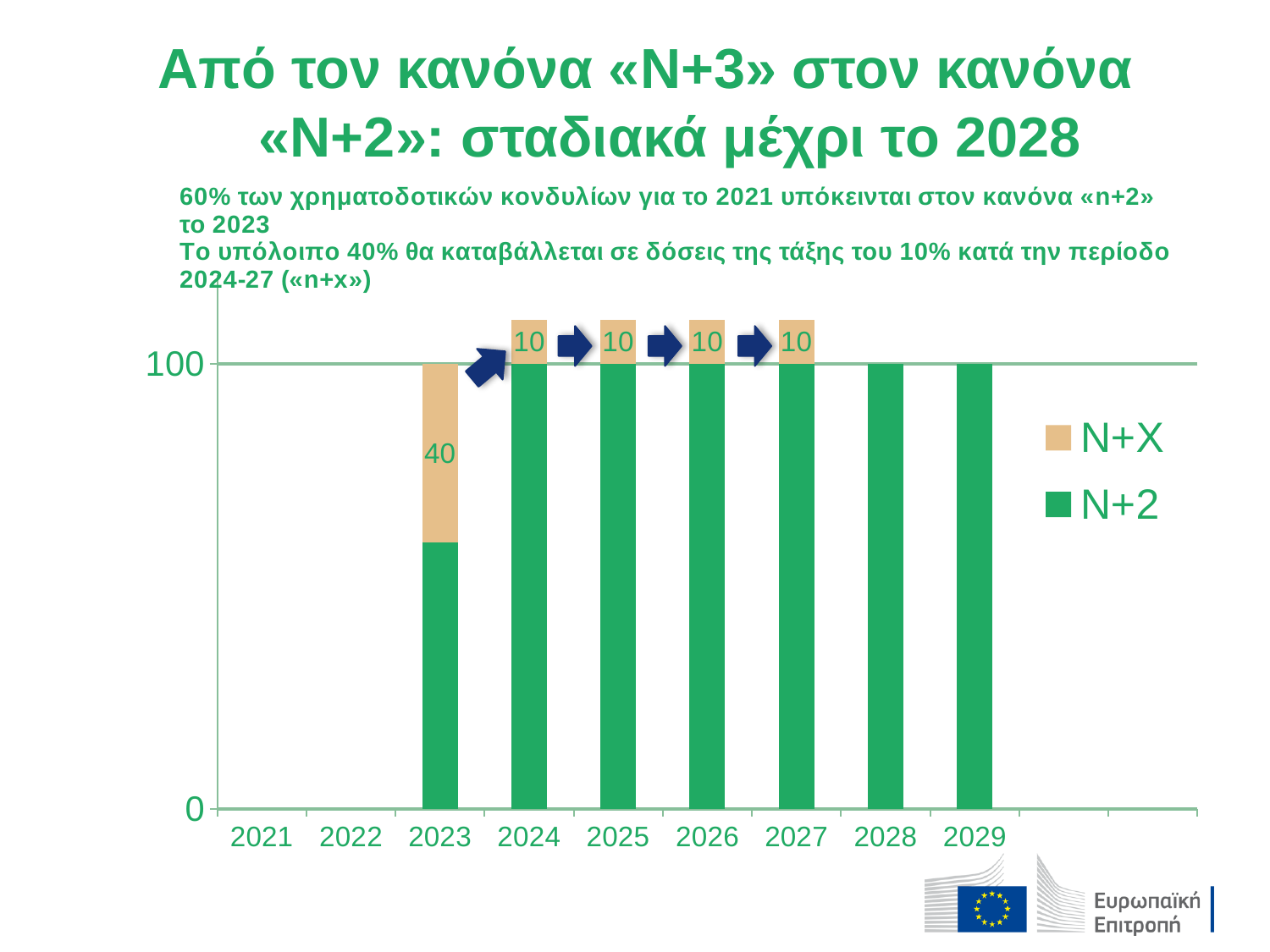
Which year has the highest N+X value? 2023 Is the N+2 value for 2023 greater or less than 100? less What is the N+X value for 2027? 10 What is the N+2 value for 2028? 100 Which is larger, the N+X value for 2023 or for 2025? 2023 How many series does the chart legend list? 2 How many years on the x axis show an N+X segment? 5 What is the N+X value for 2023? 40 What is the N+X value for 2024? 10 What are the two series named in the chart legend? N+X and N+2 What is the difference between the N+X value for 2023 and the N+X value for 2024? 30 What kind of chart is shown on the slide? bar chart